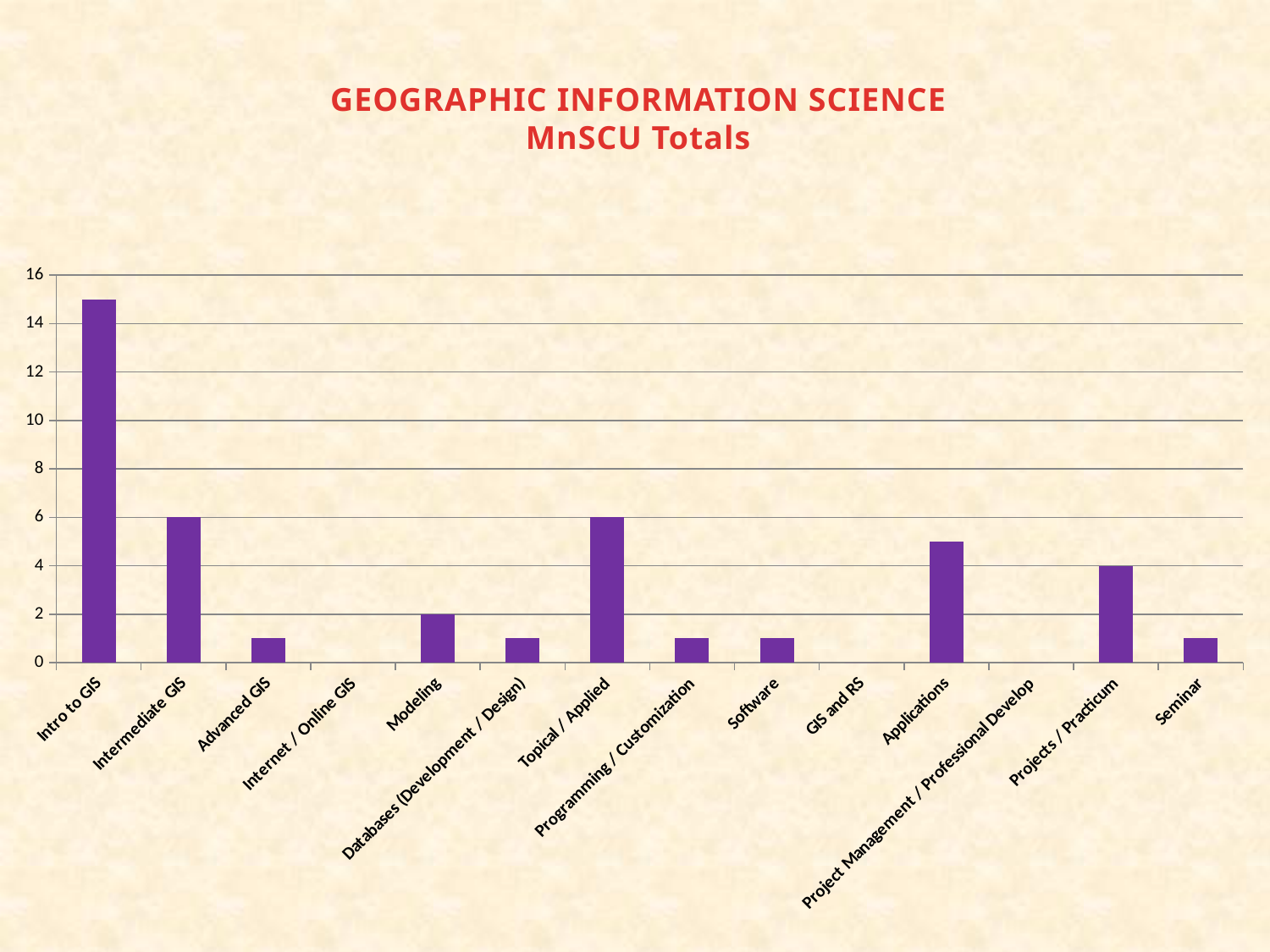
What is the value for Modeling? 2 Which category has the highest value? Intro to GIS Which is larger, the value for Applications or the value for Modeling? Applications Is the value for Intro to GIS greater or less than 14? greater What kind of chart is shown on the slide? bar chart Is the value for Advanced GIS greater or less than 2? less How many categories are shown on the x axis? 14 What is the value for Intermediate GIS? 6 Which is larger, the value for Intro to GIS or the value for Intermediate GIS? Intro to GIS What is the value for Topical / Applied? 6 What is the difference between the values for Intermediate GIS and Modeling? 4 What is the value for Projects / Practicum? 4